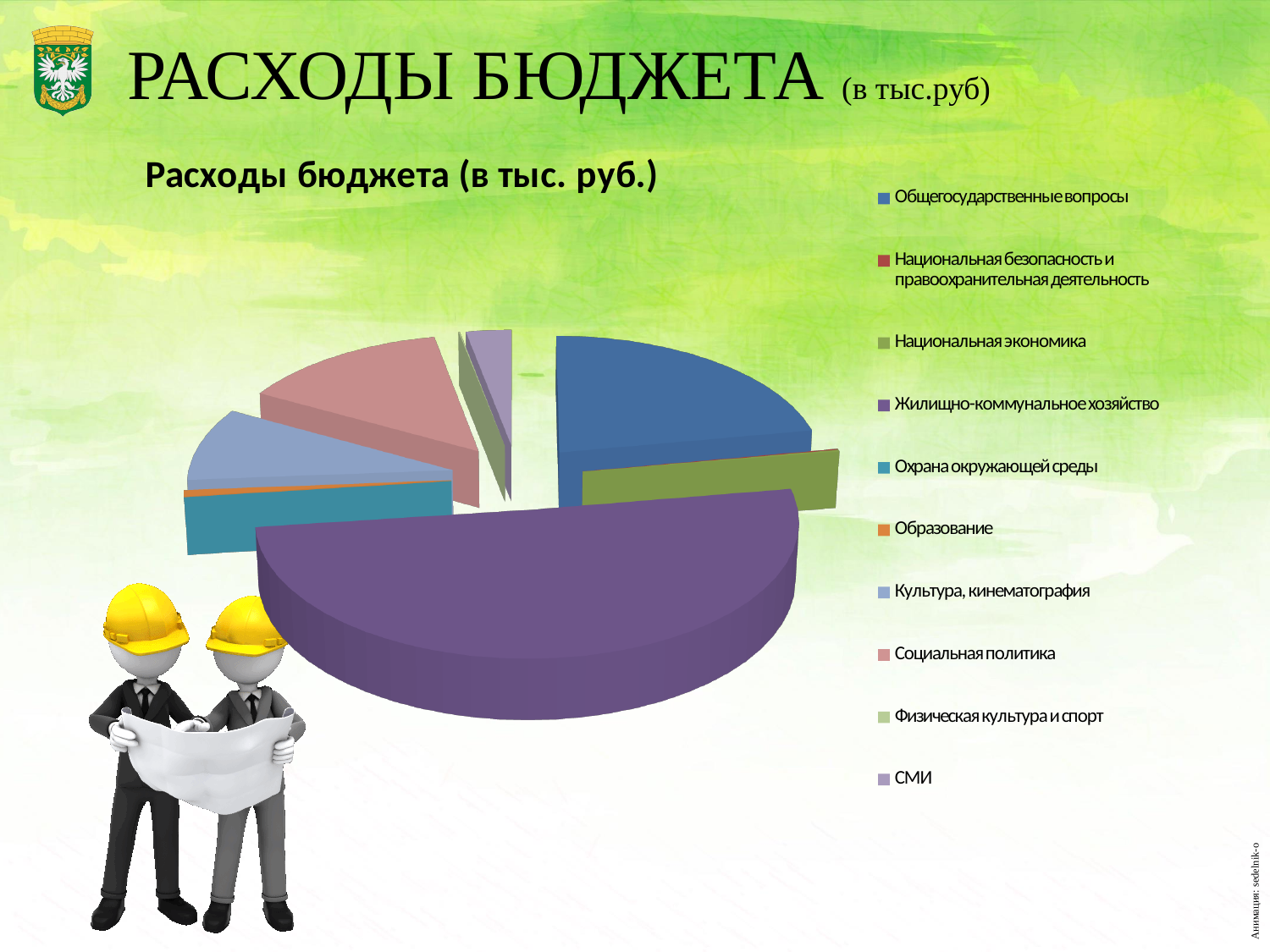
What kind of chart is shown on the slide? pie chart Which slice is larger: Жилищно-коммунальное хозяйство or Общегосударственные вопросы? Жилищно-коммунальное хозяйство Which slice is larger: Общегосударственные вопросы or Социальная политика? Общегосударственные вопросы How many categories does the pie chart's legend list? 10 What colour is the slice for Жилищно-коммунальное хозяйство? purple What unit is given in the chart title? тыс. руб. Which category has the largest slice of the pie? Жилищно-коммунальное хозяйство What is the title of the chart? Расходы бюджета (в тыс. руб.) Which slice is larger: Социальная политика or СМИ? Социальная политика